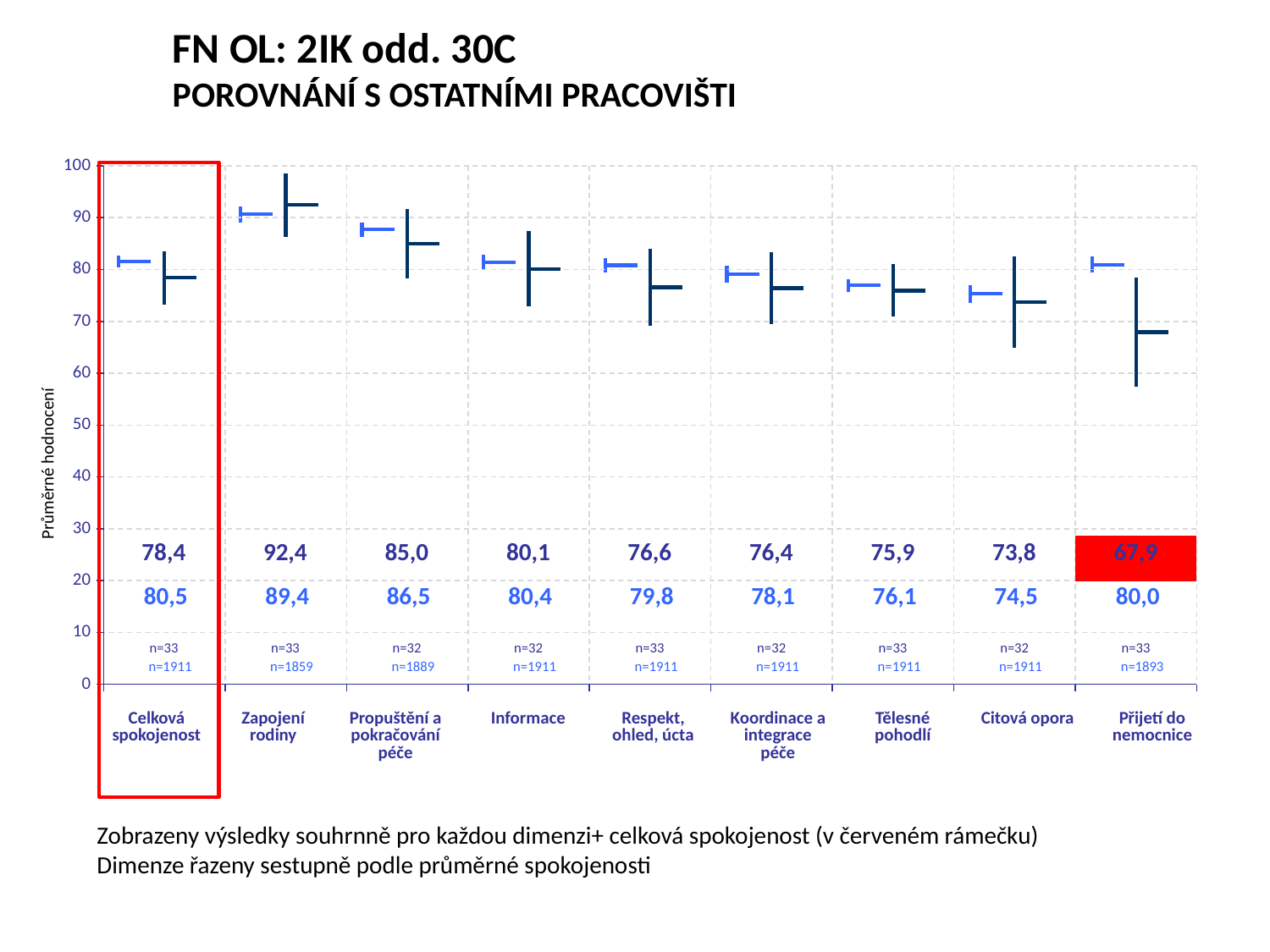
Which category has the highest dark blue value? Zapojení rodiny Which category has the lowest dark blue value? Přijetí do nemocnice What is the dark blue value shown for Zapojení rodiny? 92,4 For Přijetí do nemocnice, which is larger: the dark blue value or the light blue value? the light blue value (80,0) What is the dark blue value shown for Celková spokojenost? 78,4 What is the difference between the dark blue value for Zapojení rodiny (92,4) and for Přijetí do nemocnice (67,9)? 24,5 What is the light blue value shown for Přijetí do nemocnice? 80,0 What is the light blue value shown for Celková spokojenost? 80,5 Is the dark blue value for Citová opora greater or less than 70? greater Do the dark blue values rise or fall from Zapojení rodiny to Přijetí do nemocnice along the x axis? fall Which category's dark blue value is highlighted with a red background? Přijetí do nemocnice How many categories are shown on the x axis of the chart? 9